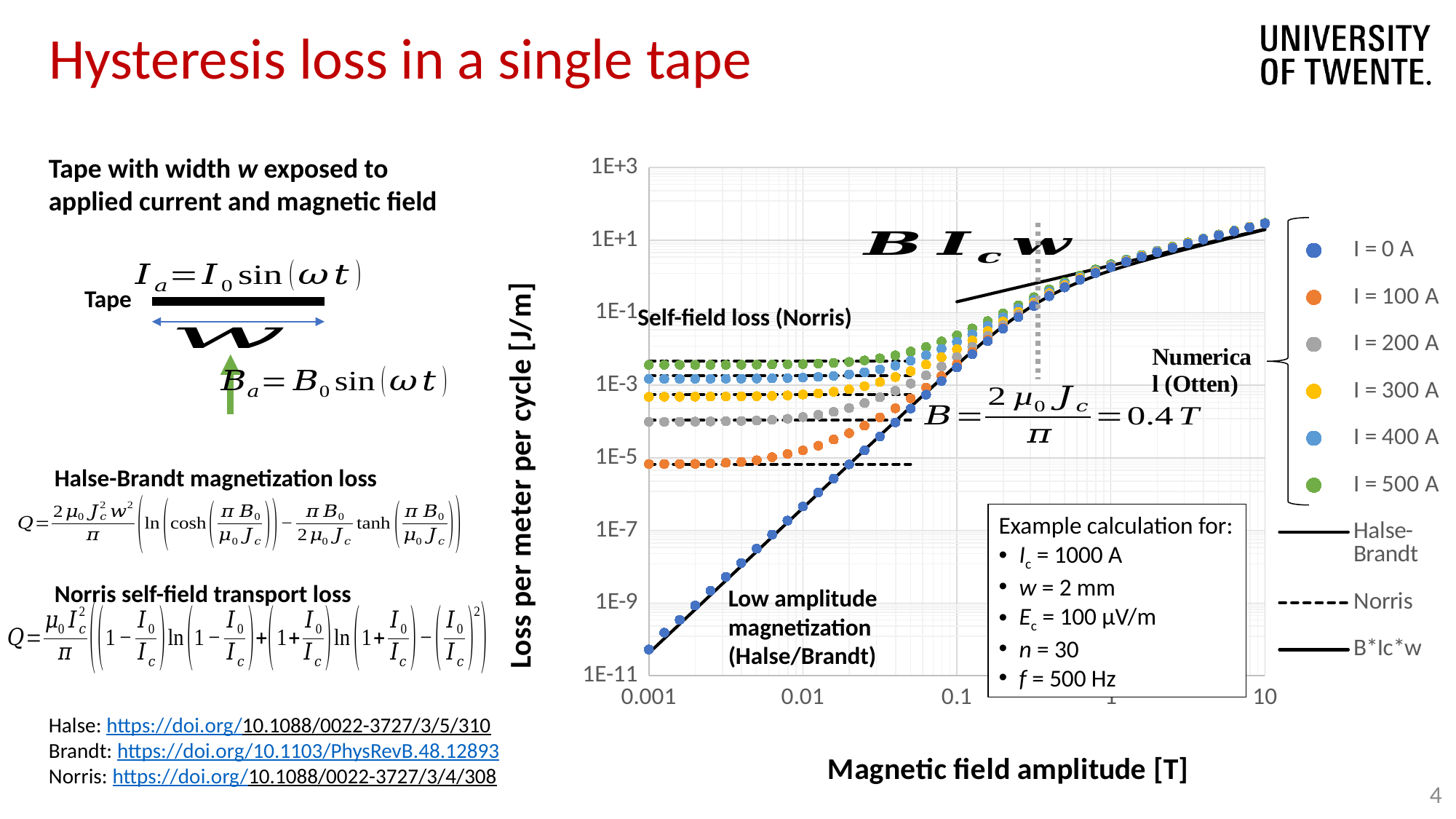
What is the highest value shown on the y axis of the chart? 1E+3 Which current series has the highest loss at a magnetic field amplitude of 0.001 T? I = 500 A How many entries does the chart legend list? 9 Does the loss for I = 0 A rise or fall as the magnetic field amplitude increases? rise At a magnetic field amplitude of 0.01 T, which has the larger loss: I = 200 A or I = 400 A? I = 400 A Which current series has the lowest loss at a magnetic field amplitude of 0.001 T? I = 0 A At a magnetic field amplitude of 0.001 T, is the loss for I = 100 A greater or less than 1E-5 J/m? less What is the title of the x axis of the chart? Magnetic field amplitude [T] What kind of chart is shown on the slide? scatter chart At a magnetic field amplitude of 0.001 T, is the loss for I = 0 A greater or less than 1E-9 J/m? less At a magnetic field amplitude of 0.001 T, is the loss for I = 500 A greater or less than 1E-3 J/m? greater What is the title of the y axis of the chart? Loss per meter per cycle [J/m]